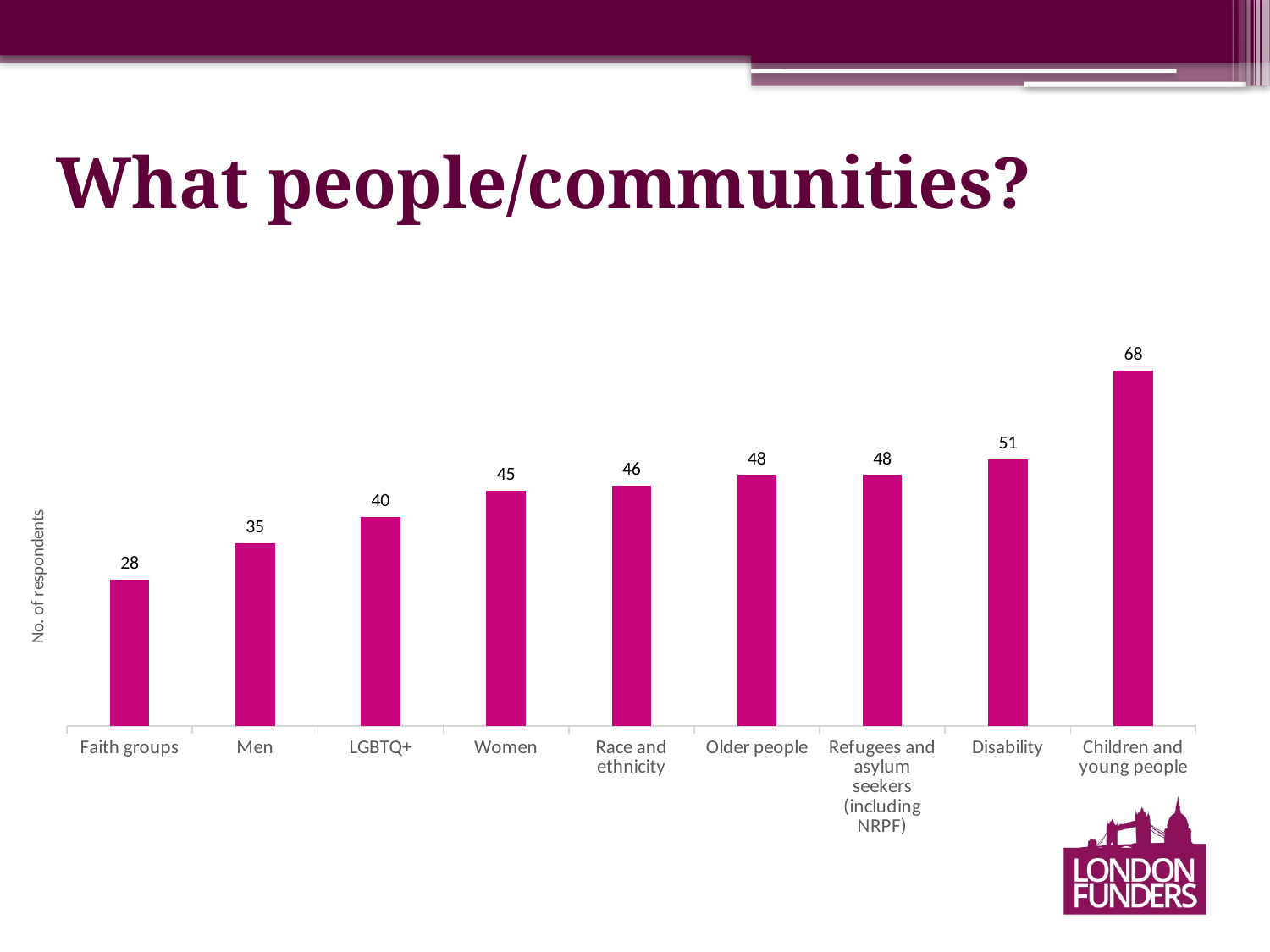
Which has more respondents, Women or LGBTQ+? Women What is the difference in respondents between Men and Faith groups? 7 What is the number of respondents for Refugees and asylum seekers (including NRPF)? 48 What is the number of respondents for Disability? 51 What is the number of respondents for Faith groups? 28 What is the difference in respondents between Children and young people and Disability? 17 What kind of chart is shown on the slide? Bar chart How many categories are shown on the chart? 9 Which category has the highest number of respondents? Children and young people Which category has the lowest number of respondents? Faith groups Do the values rise or fall from left to right along the x axis? Rise What is the label on the vertical axis of the chart? No. of respondents